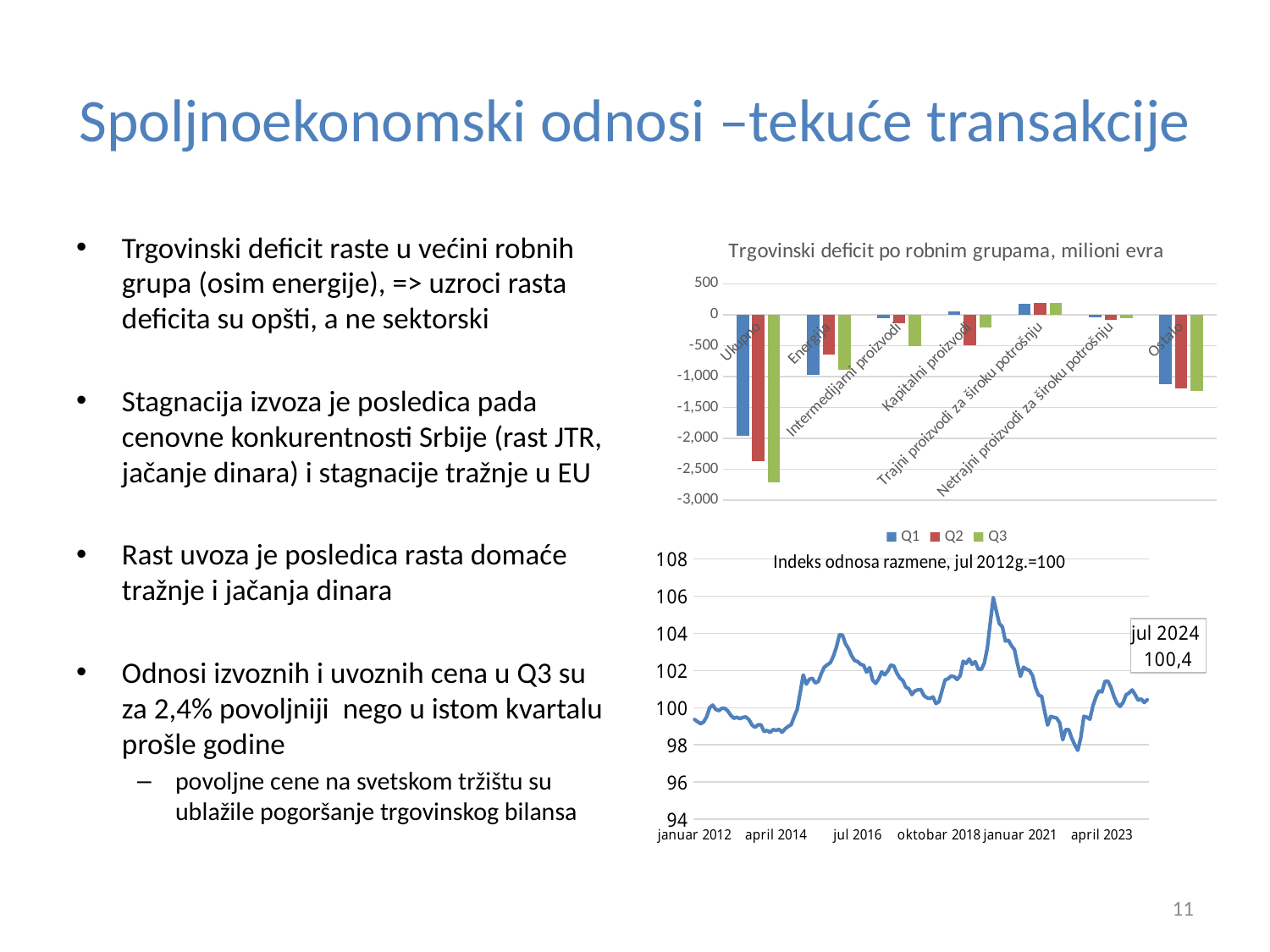
In the chart 'Indeks odnosa razmene, jul 2012g.=100', is the highest point of the line greater or less than 104? greater In the chart 'Indeks odnosa razmene, jul 2012g.=100', what is the value labelled for jul 2024? 100,4 In the chart 'Trgovinski deficit po robnim grupama, milioni evra', is the Q3 value for Ukupno greater or less than -2,500? less How many product-group categories are shown in the chart 'Trgovinski deficit po robnim grupama, milioni evra'? 7 What are the legend entries of the chart 'Trgovinski deficit po robnim grupama, milioni evra'? Q1, Q2, Q3 What kind of chart is 'Trgovinski deficit po robnim grupama, milioni evra'? bar chart In the chart 'Trgovinski deficit po robnim grupama, milioni evra', which category has positive values in all three quarters? Trajni proizvodi za široku potrošnju How many series does the legend of the chart 'Trgovinski deficit po robnim grupama, milioni evra' list? 3 In the chart 'Trgovinski deficit po robnim grupama, milioni evra', which category has the lowest Q3 value? Ukupno In the chart 'Trgovinski deficit po robnim grupama, milioni evra', is the Q2 value for Energija greater or less than -1,000? greater What kind of chart is 'Indeks odnosa razmene, jul 2012g.=100'? line chart In the chart 'Trgovinski deficit po robnim grupama, milioni evra', which is larger for Ukupno: the Q1 value or the Q3 value? Q1